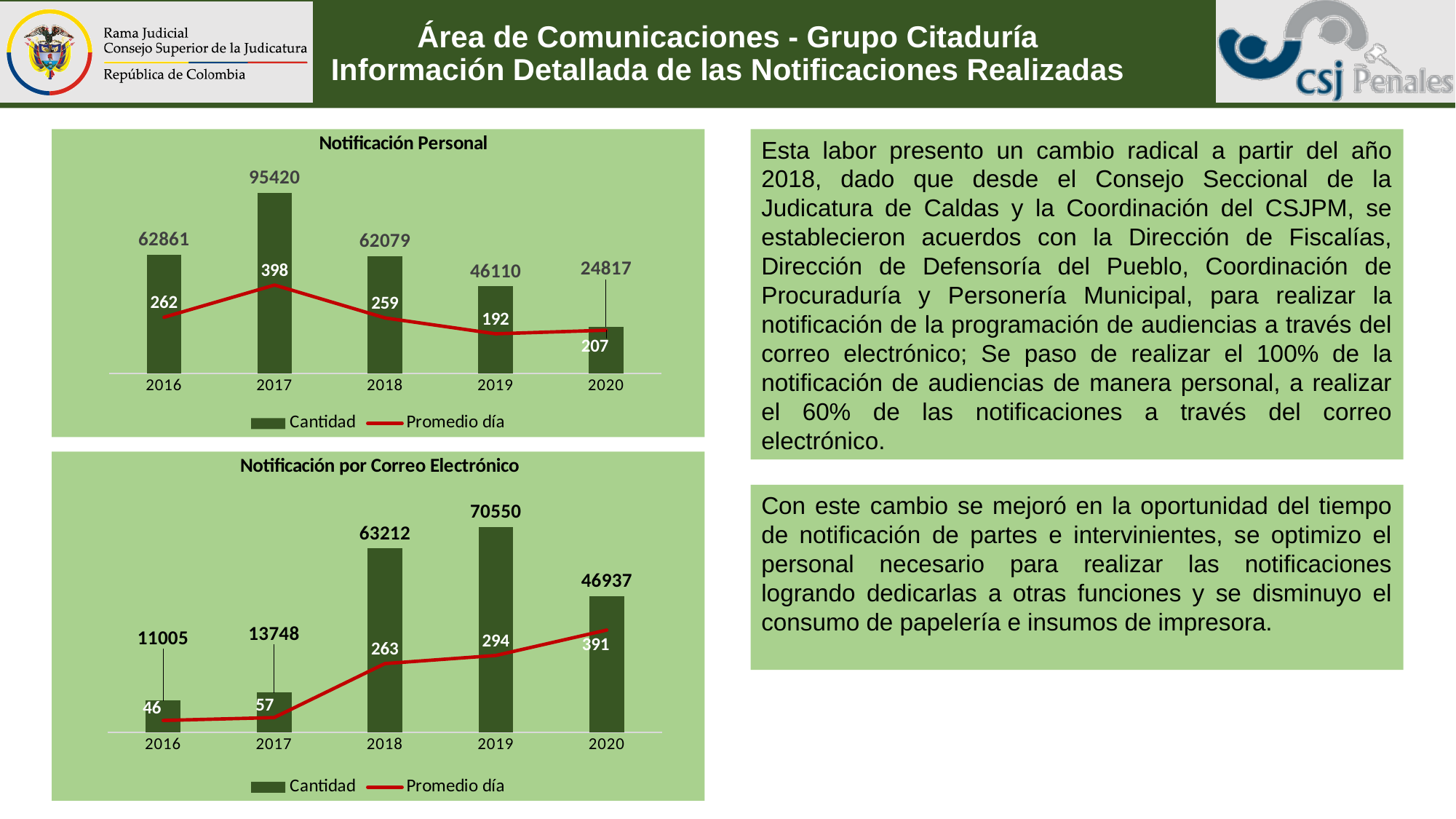
How many years are shown on the x axis of the 'Notificación por Correo Electrónico' chart? 5 In the 'Notificación Personal' chart, what is the Cantidad value for 2017? 95420 In the 'Notificación Personal' chart, which year has the highest Cantidad? 2017 In the 'Notificación Personal' chart, what is the difference in Cantidad between 2018 and 2019? 15969 In the 'Notificación por Correo Electrónico' chart, what is the Promedio día value for 2018? 263 How many series does the legend of the 'Notificación Personal' chart list? 2 In the 'Notificación por Correo Electrónico' chart, which year has the lowest Promedio día? 2016 In the 'Notificación por Correo Electrónico' chart, which year has the highest Cantidad? 2019 In the 'Notificación por Correo Electrónico' chart, what is the Cantidad value for 2020? 46937 In the 'Notificación por Correo Electrónico' chart, is the Cantidad for 2018 or 2020 larger? 2018 In the 'Notificación Personal' chart, what is the Promedio día value for 2019? 192 In the 'Notificación Personal' chart, which year has the lowest Cantidad? 2020